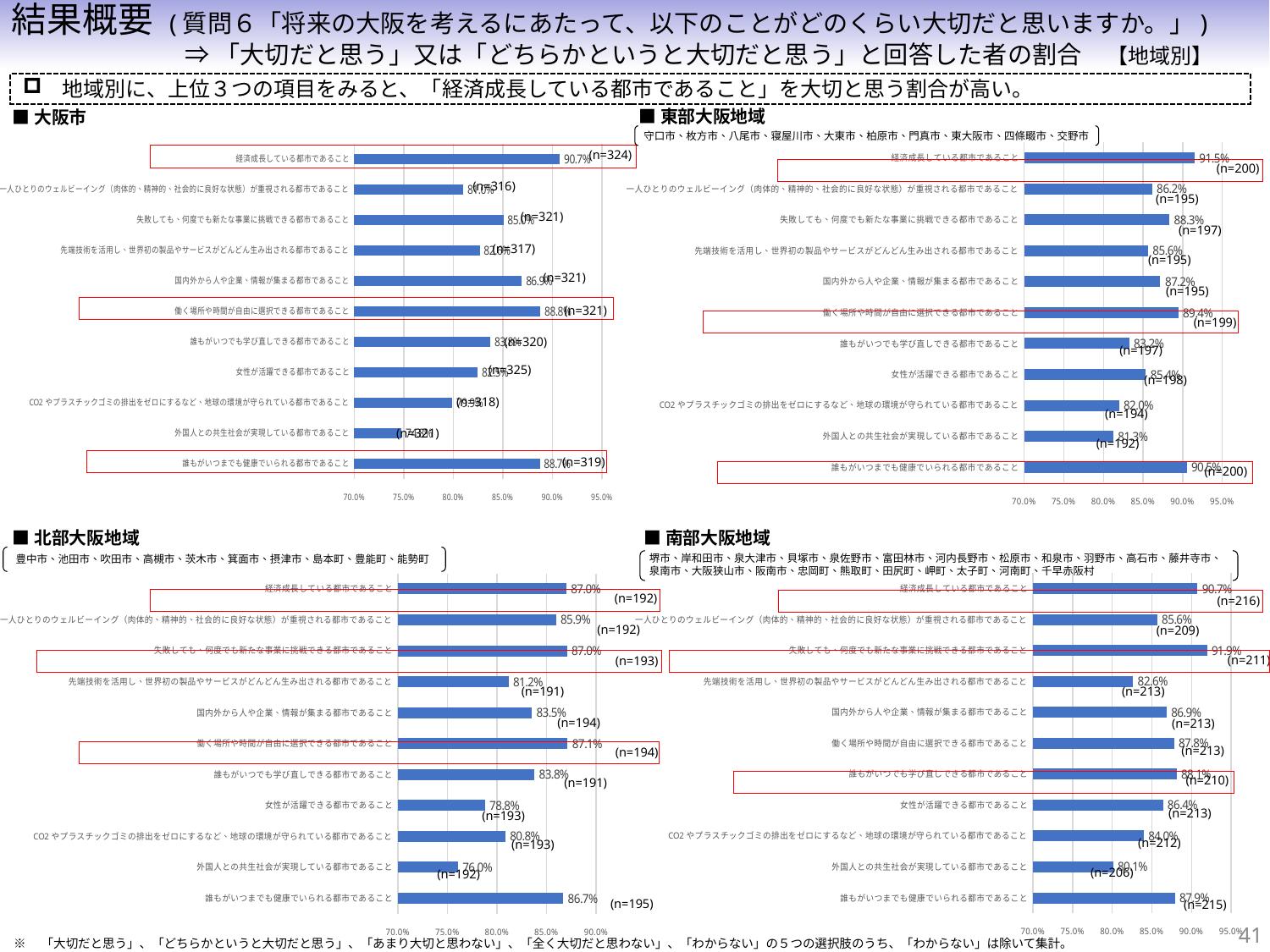
In the 東部大阪地域 chart, what is the value for 誰もがいつまでも健康でいられる都市であること? 90.5% What kind of chart is the 大阪市 chart? bar chart In the 南部大阪地域 chart, which is larger: the value for 国内外から人や企業、情報が集まる都市であること or the value for 女性が活躍できる都市であること? 国内外から人や企業、情報が集まる都市であること In the 南部大阪地域 chart, what is the value for 失敗しても、何度でも新たな事業に挑戦できる都市であること? 91.9% In the 北部大阪地域 chart, is the value for 女性が活躍できる都市であること greater or less than 80.0%? less In the 北部大阪地域 chart, what is the value for 働く場所や時間が自由に選択できる都市であること? 87.1% In the 北部大阪地域 chart, which category has the lowest value? 外国人との共生社会が実現している都市であること In the 東部大阪地域 chart, what is the value for 経済成長している都市であること? 91.5% In the 大阪市 chart, what is the value for 経済成長している都市であること? 90.7% How many categories are plotted in the 東部大阪地域 chart? 11 In the 東部大阪地域 chart, what is the difference between the values for 経済成長している都市であること and 外国人との共生社会が実現している都市であること? 10.2% In the 南部大阪地域 chart, which category has the highest value? 失敗しても、何度でも新たな事業に挑戦できる都市であること